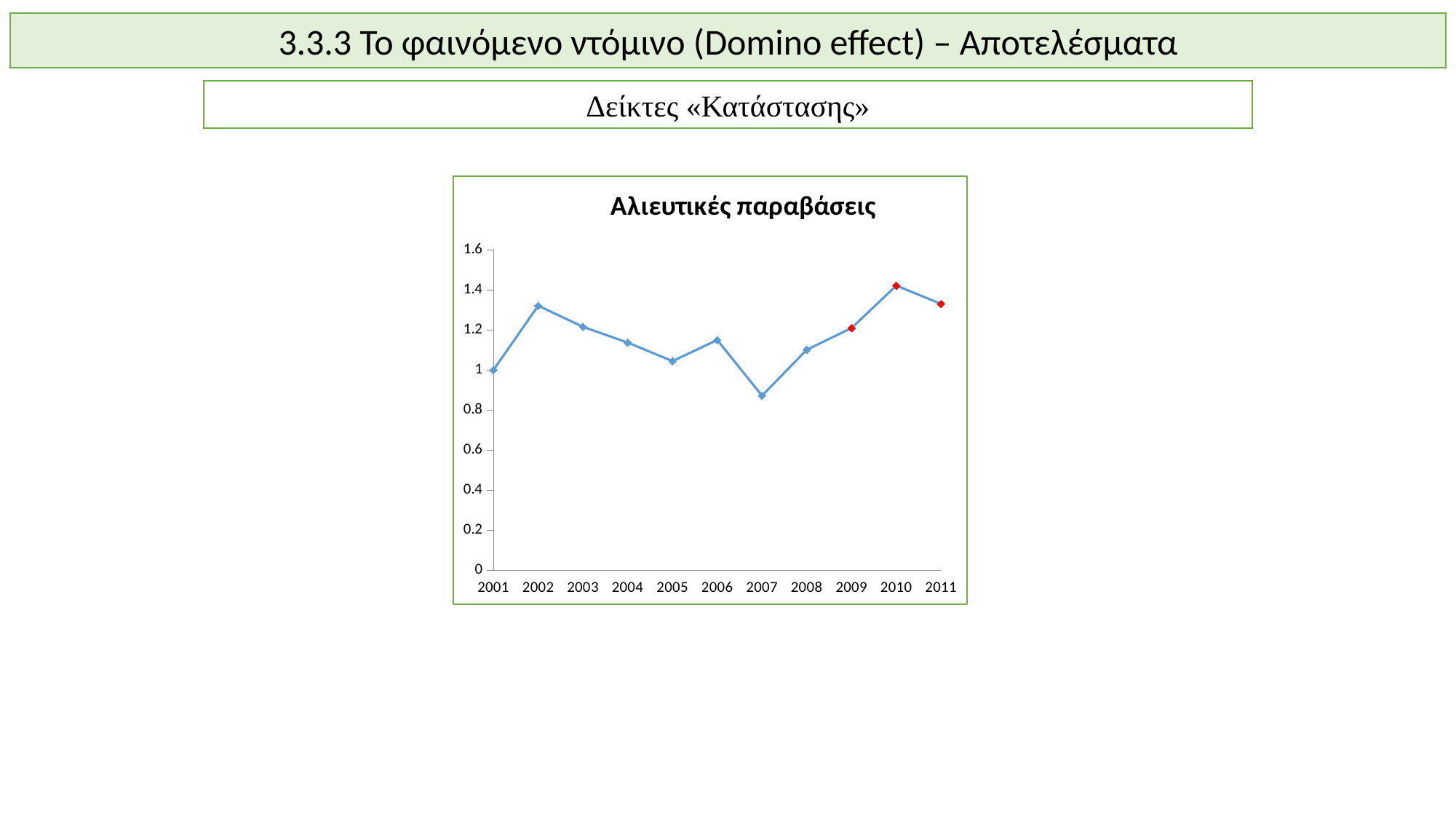
How many years are plotted on the x axis of the chart? 11 Do the values rise or fall from 2007 to 2010? rise Which year has the highest value in the chart? 2010 Is the value for 2010 greater or less than 1.2? greater Is the value for 2002 greater or less than 1.2? greater Which year has the larger value, 2010 or 2011? 2010 Which year has the lowest value in the chart? 2007 What is the title of the chart? Αλιευτικές παραβάσεις What kind of chart is shown on the slide? line chart Which year has the larger value, 2006 or 2007? 2006 Is the value for 2004 greater or less than 1.2? less